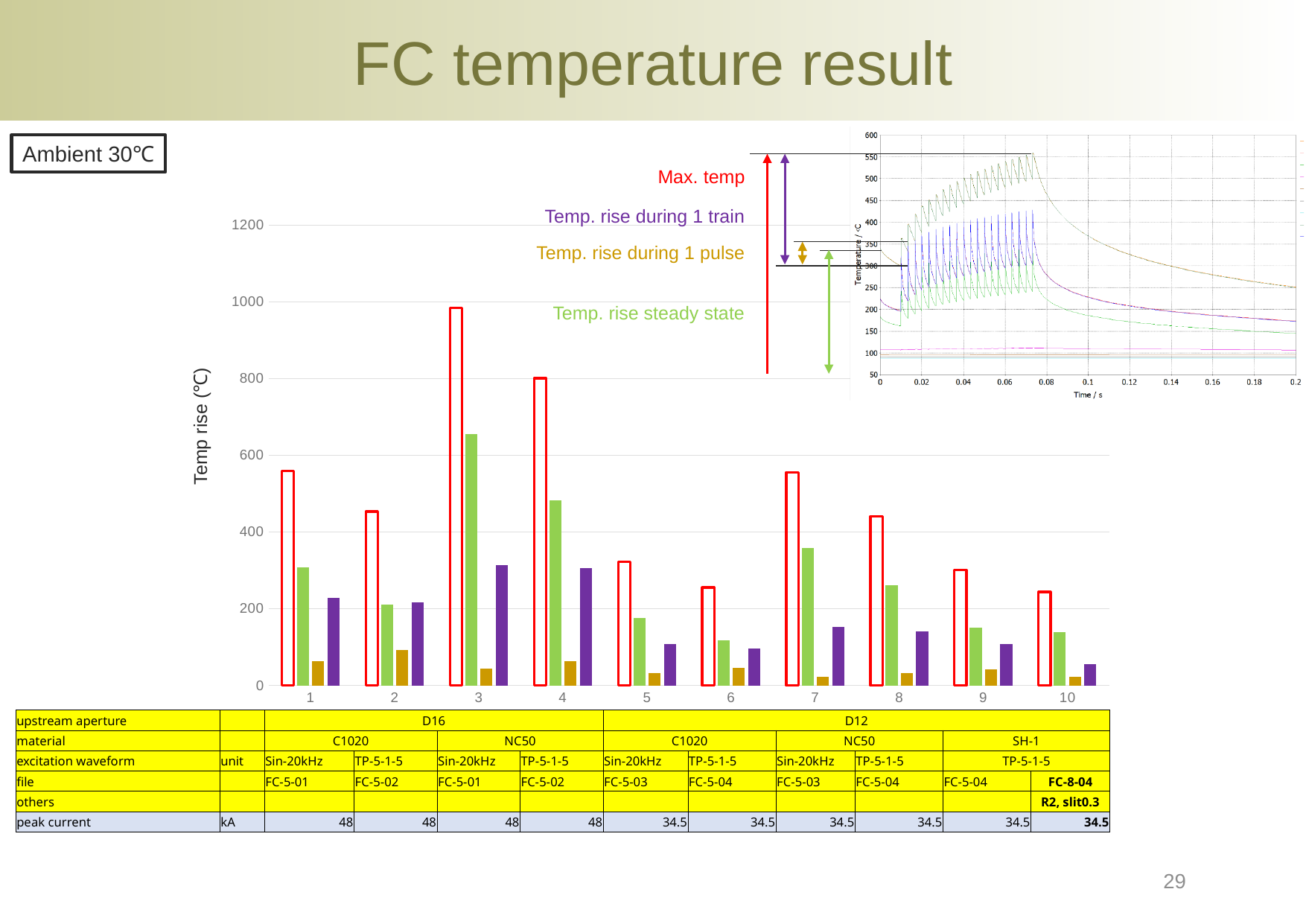
In the bar chart, which category has the highest Max. temp? 3 How many categories are shown on the x axis of the bar chart? 10 In the bar chart, is the Temp. rise steady state for category 4 greater or less than 400? greater In the bar chart, which category has the lowest Temp. rise during 1 train? 10 What is the y-axis label of the bar chart? Temp rise (℃) In the bar chart, is the Max. temp for category 1 greater or less than 600? less In the bar chart, is the Max. temp for category 3 greater or less than 800? greater In the bar chart, which category has the highest Temp. rise steady state? 3 What kind of chart is the large chart on the slide? bar chart In the bar chart, which is larger: the Temp. rise steady state for category 1 or for category 2? category 1